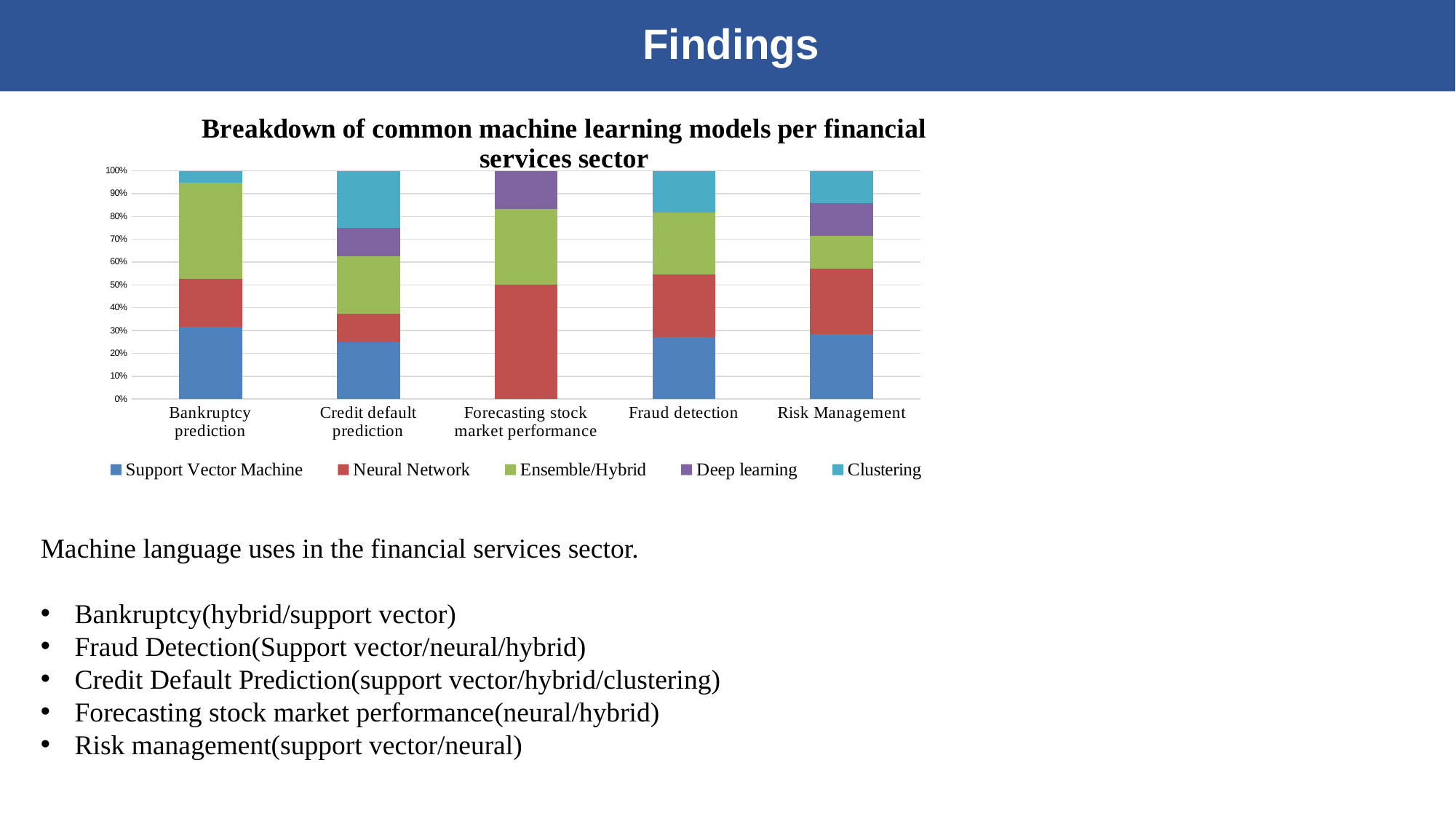
What kind of chart is shown on the slide? Stacked bar chart What is the title of the chart? Breakdown of common machine learning models per financial services sector Which series is shown in red in the chart? Neural Network Is the Support Vector Machine share for Bankruptcy prediction greater or less than 40%? less Is the Neural Network share for Forecasting stock market performance greater or less than 40%? greater How many series does the chart's legend list? 5 Which category has the largest Clustering share? Credit default prediction Which category has no Support Vector Machine segment in its bar? Forecasting stock market performance Which category has the largest Neural Network share? Forecasting stock market performance Which is larger: the Neural Network share for Forecasting stock market performance or the Neural Network share for Bankruptcy prediction? Forecasting stock market performance What is the total height of the stacked bar for Fraud detection? 100% How many financial services sectors (categories) are shown on the x axis of the chart? 5